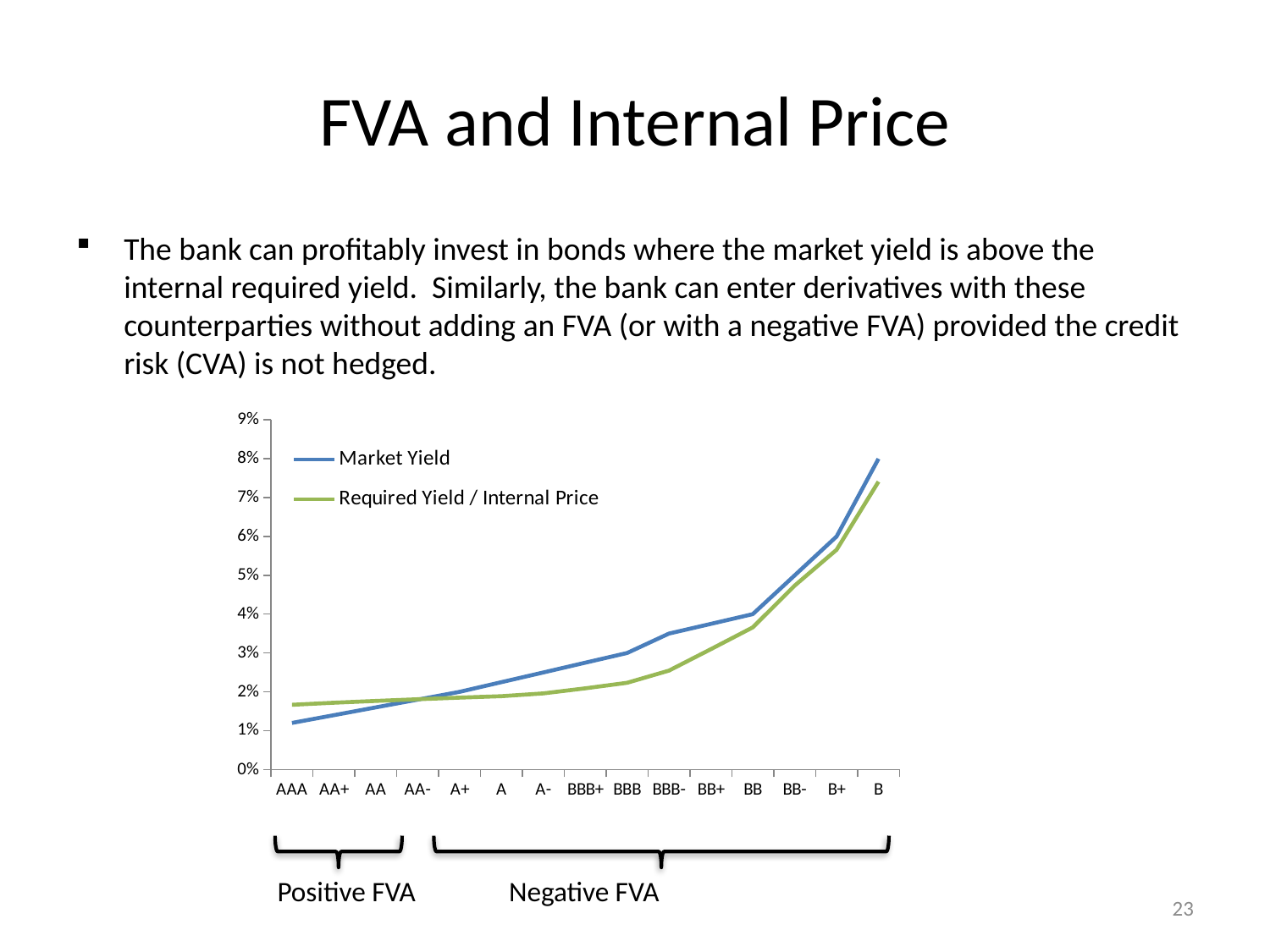
Do the Market Yield values rise or fall as the ratings move from AAA to B along the x axis? Rise Which rating category has the lowest Market Yield? AAA Is the Market Yield for B greater or less than 7%? greater How many series does the chart legend list? 2 Is the Required Yield / Internal Price for BB greater or less than 4%? less At the AAA rating, which series is higher: Market Yield or Required Yield / Internal Price? Required Yield / Internal Price Which rating category has the highest Required Yield / Internal Price? B At the B rating, which series is higher: Market Yield or Required Yield / Internal Price? Market Yield Which rating category has the highest Market Yield? B Is the Market Yield for AAA greater or less than 2%? less What kind of chart is shown on the slide? Line chart How many rating categories are shown on the x axis of the chart? 15